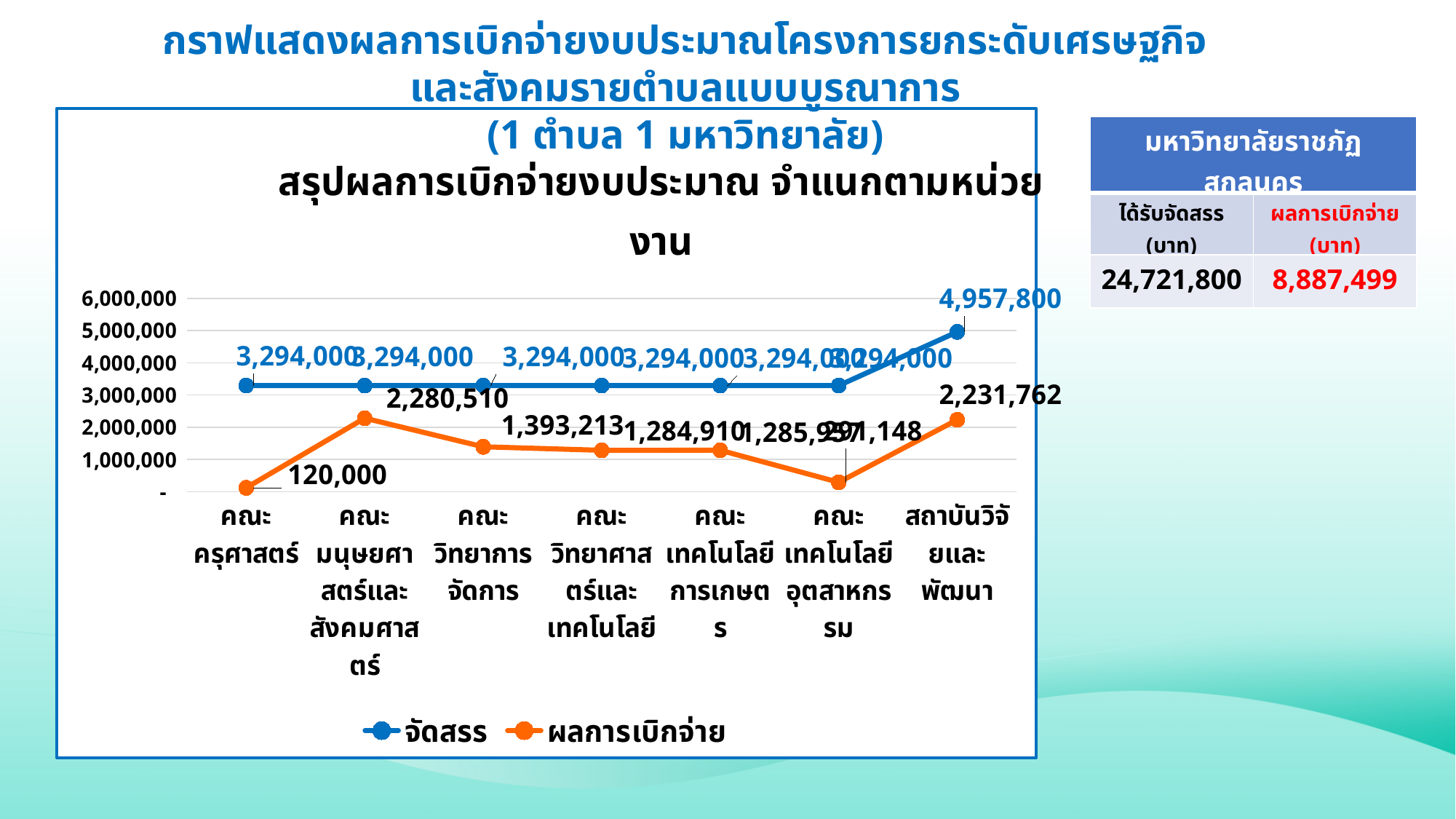
Which has the larger ผลการเบิกจ่าย value: คณะวิทยาการจัดการ or คณะวิทยาศาสตร์และเทคโนโลยี? คณะวิทยาการจัดการ What kind of chart is shown on the slide? line chart Is the ผลการเบิกจ่าย value for คณะเทคโนโลยีอุตสาหกรรม greater or less than 1,000,000? less What is the ผลการเบิกจ่าย value for คณะครุศาสตร์? 120,000 What is the ผลการเบิกจ่าย value for คณะวิทยาการจัดการ? 1,393,213 Which unit has the lowest ผลการเบิกจ่าย value? คณะครุศาสตร์ What is the ผลการเบิกจ่าย value for คณะมนุษยศาสตร์และสังคมศาสตร์? 2,280,510 How many units (categories) are plotted along the x axis of the chart? 7 For สถาบันวิจัยและพัฒนา, what is the difference between the จัดสรร value and the ผลการเบิกจ่าย value? 2,726,038 What is the จัดสรร value for สถาบันวิจัยและพัฒนา? 4,957,800 Which unit has the highest ผลการเบิกจ่าย value? คณะมนุษยศาสตร์และสังคมศาสตร์ How many series does the chart legend list? 2